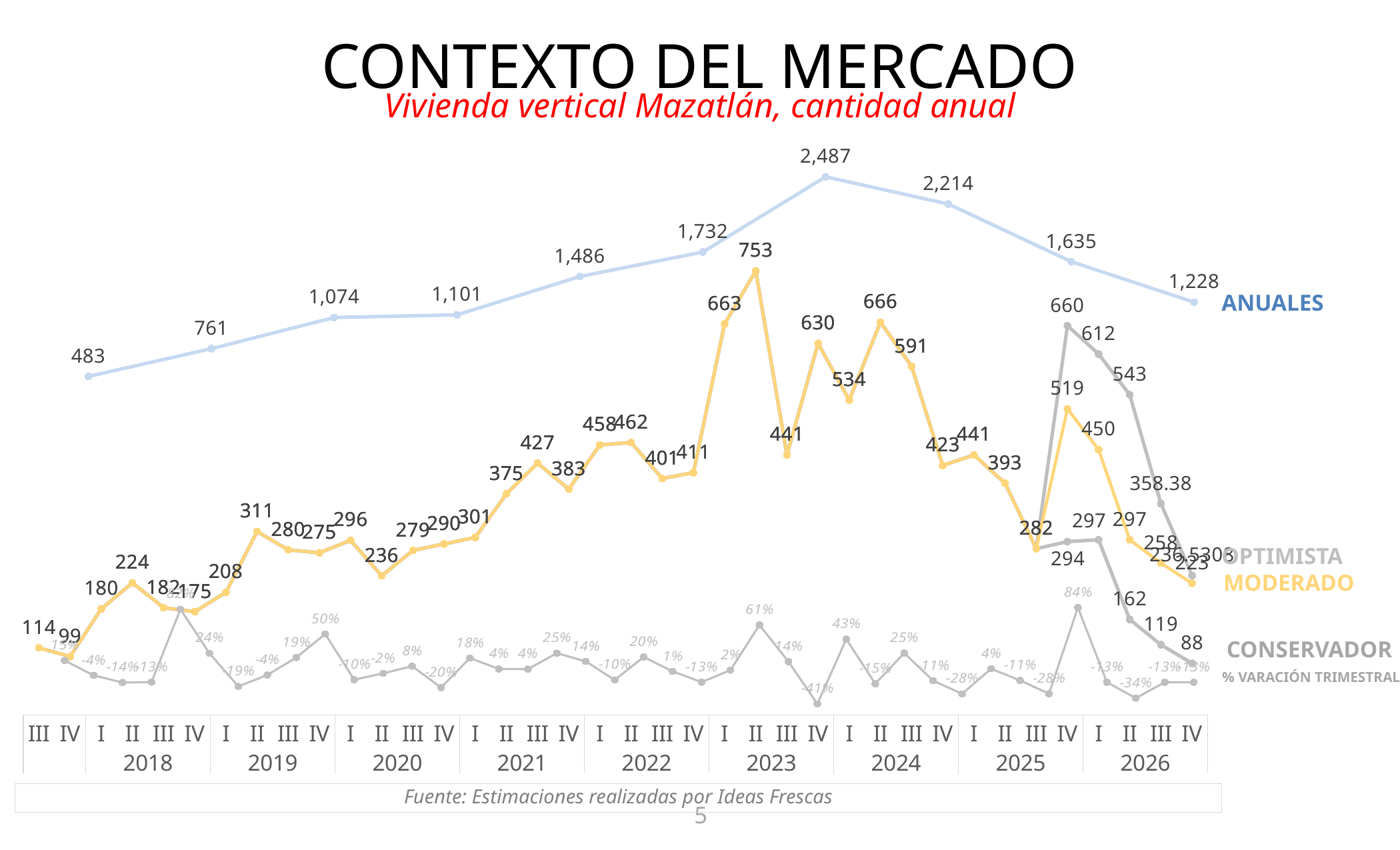
Which is larger, the ANUALES value for 2022 (1,732) or for 2021 (1,486)? 2022 (1,732) What is the ANUALES value for 2023? 2,487 What is the ANUALES value for 2026? 1,228 What is the lowest value on the ANUALES line? 483 How many data points does the ANUALES line have? 10 What is the subtitle of the chart shown in red? Vivienda vertical Mazatlán, cantidad anual What type of chart is shown on the slide? Line chart Does the ANUALES line rise or fall from 2023 to 2026? Fall What is the highest value on the ANUALES line? 2,487 What is the highest value labelled on the MODERADO (yellow) line? 753 What is the difference between the ANUALES values for 2023 (2,487) and 2024 (2,214)? 273 What is the lowest value labelled on the CONSERVADOR line? 88